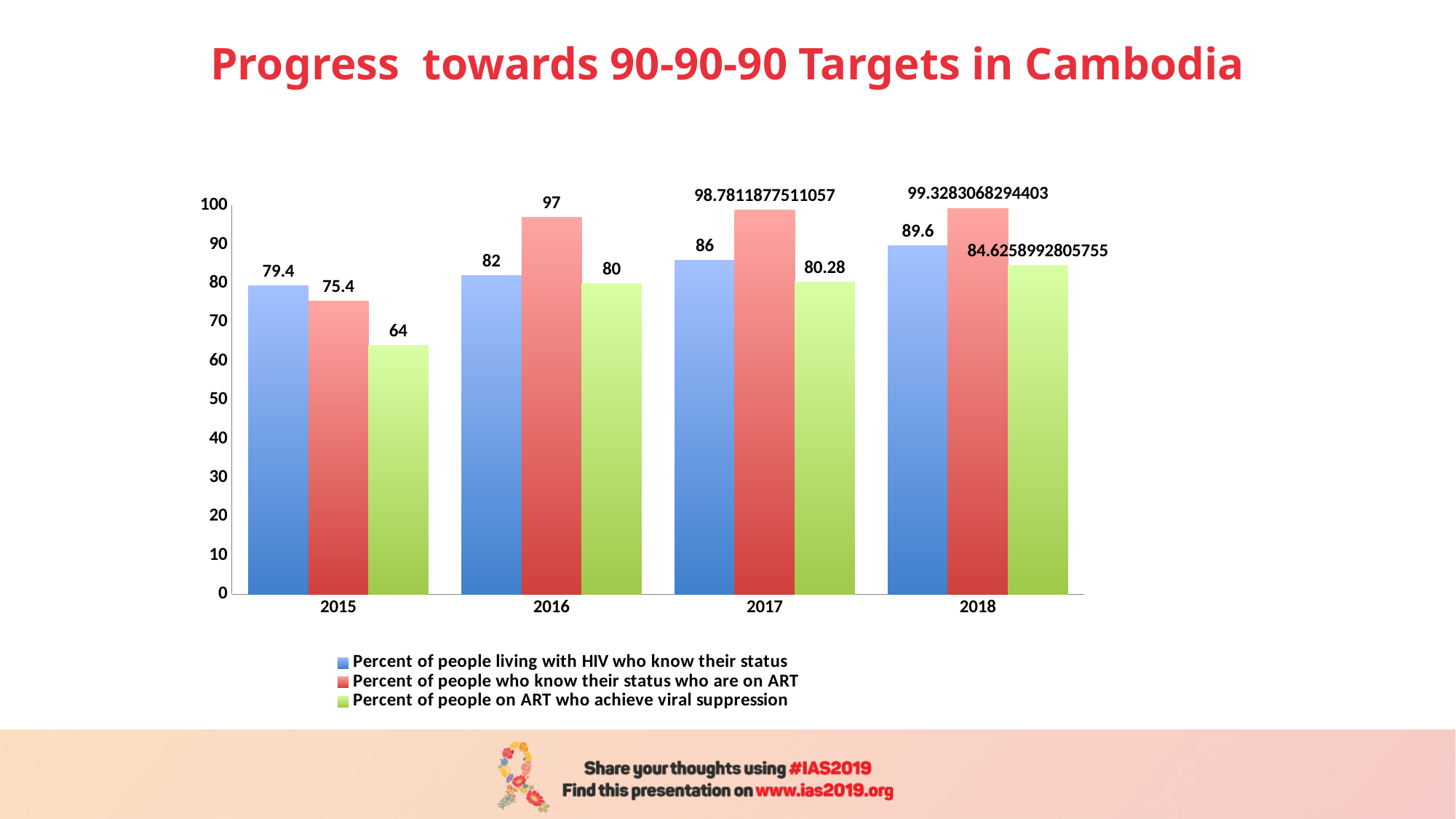
Which is larger in 2015: 'Percent of people living with HIV who know their status' or 'Percent of people who know their status who are on ART'? Percent of people living with HIV who know their status In which year is 'Percent of people living with HIV who know their status' highest? 2018 How many series does the legend list? 3 What is the value for 'Percent of people who know their status who are on ART' in 2016? 97 In which year is 'Percent of people on ART who achieve viral suppression' lowest? 2015 What is the value for 'Percent of people living with HIV who know their status' in 2015? 79.4 What is the value for 'Percent of people living with HIV who know their status' in 2018? 89.6 What is the value for 'Percent of people on ART who achieve viral suppression' in 2017? 80.28 What is the difference between 'Percent of people living with HIV who know their status' in 2016 and in 2015? 2.6 Is the value for 'Percent of people who know their status who are on ART' in 2018 greater or less than 90? greater Does 'Percent of people who know their status who are on ART' rise or fall from 2015 to 2018? rise How many years are shown on the x axis? 4